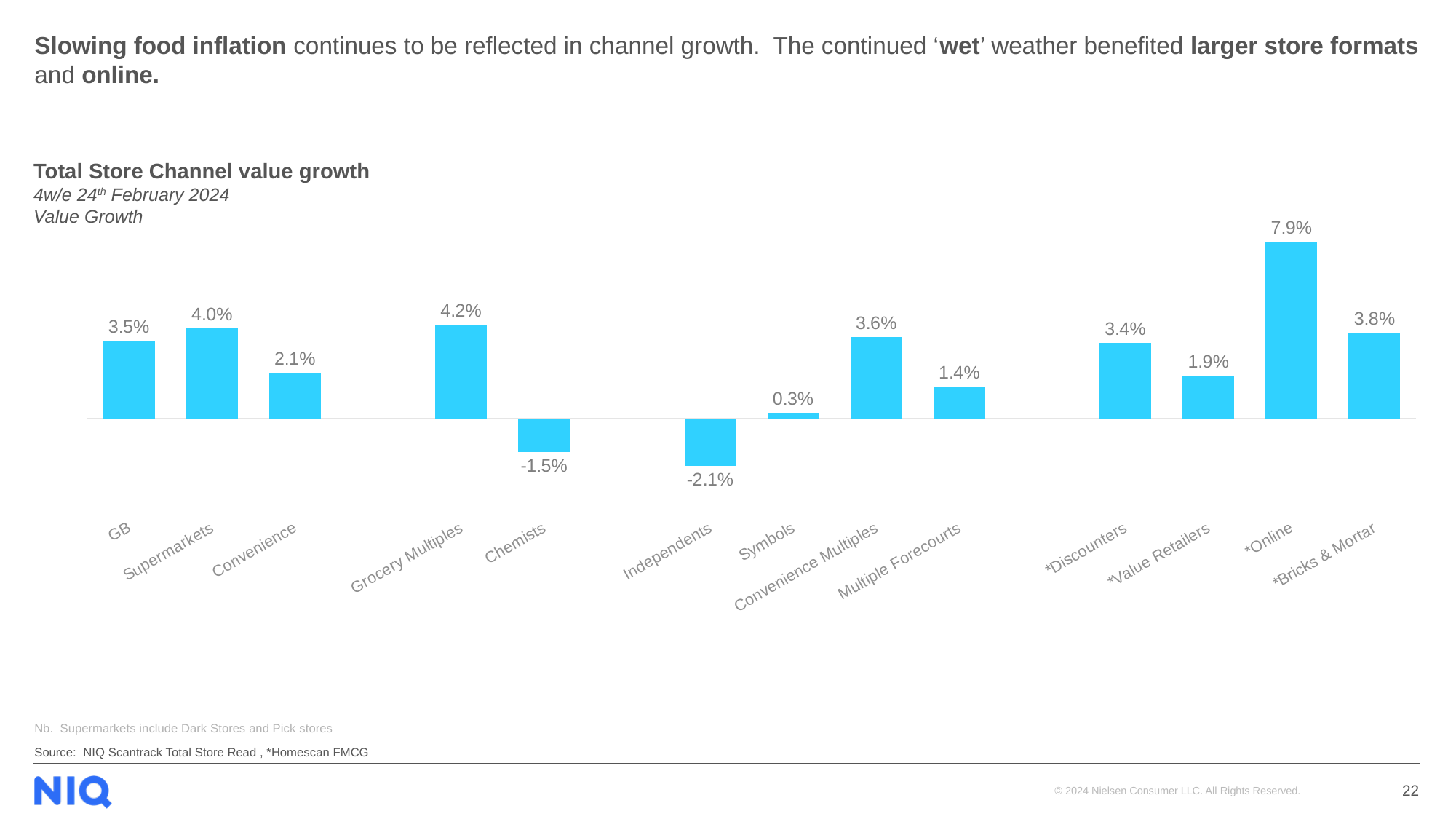
What is the value growth for Multiple Forecourts? 1.4% How many channels are shown in the chart? 14 What is the difference between the value growth for *Online and GB? 4.4% Which channel has the lowest value growth? Independents Which channel has the highest value growth? *Online What is the value growth for *Online? 7.9% What period does the chart cover? 4w/e 24th February 2024 Which has higher value growth, Grocery Multiples or Convenience Multiples? Grocery Multiples How many channels show negative value growth? 2 What type of chart is shown on the slide? Bar chart What is the value growth for Supermarkets? 4.0% What is the value growth for Independents? -2.1%